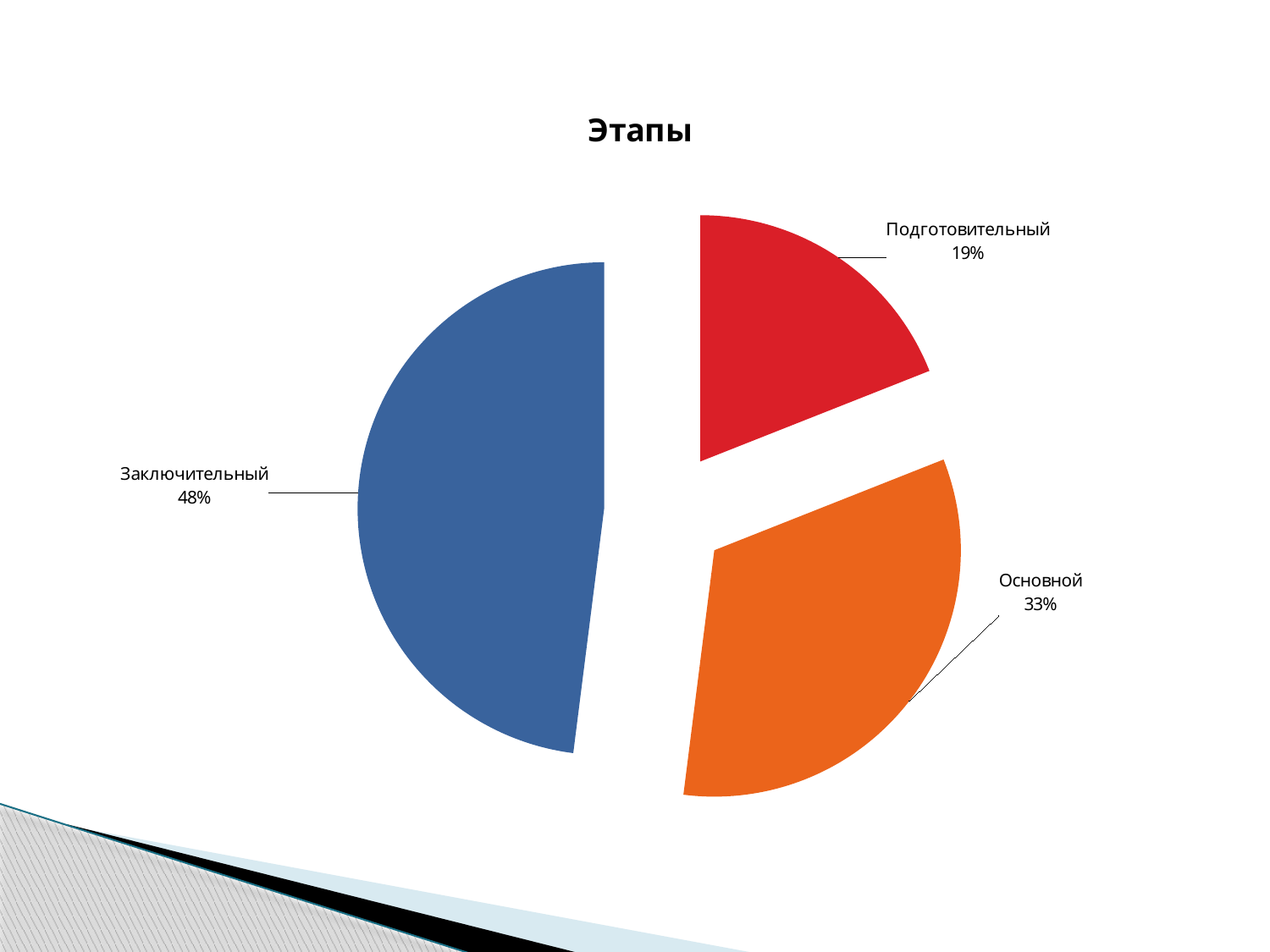
What is the difference in percentage points between Заключительный and Основной? 15 What kind of chart is shown on the slide? pie chart How many slices does the pie chart have? 3 Which slice is the smallest? Подготовительный What is the title of the chart? Этапы What share of the pie does Основной have? 33% Which is larger, Основной or Подготовительный? Основной What share of the pie does Заключительный have? 48% What is the difference in percentage points between Основной and Подготовительный? 14 What share of the pie does Подготовительный have? 19% What colour is the Заключительный slice? blue Which slice is the largest? Заключительный